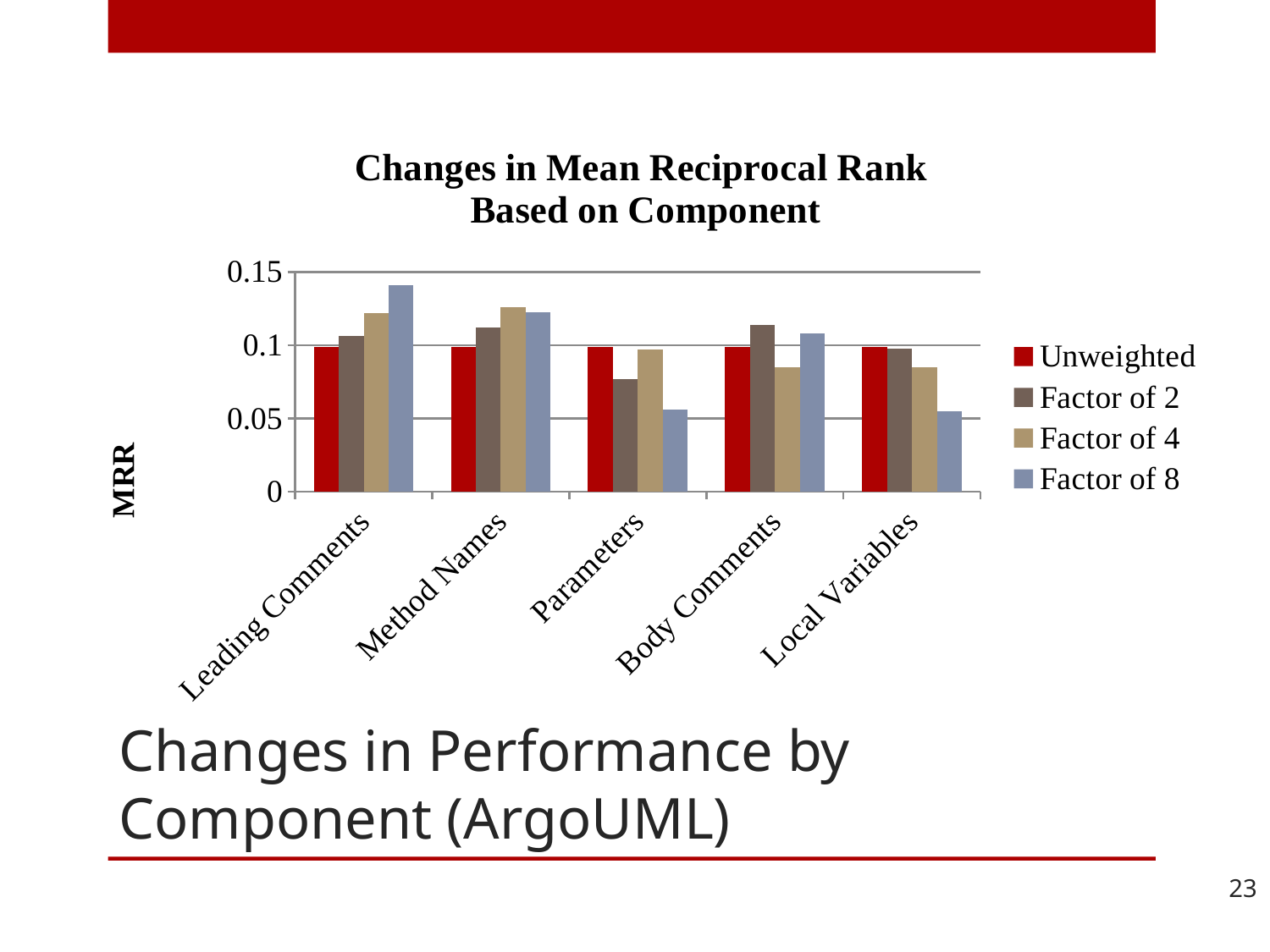
What kind of chart is shown on the slide? Bar chart What is the label on the vertical axis? MRR For Parameters, which is larger: the Factor of 2 value or the Factor of 8 value? Factor of 2 Is the Factor of 8 value for Leading Comments greater or less than 0.1? greater What is the title of the chart? Changes in Mean Reciprocal Rank Based on Component Is the Factor of 4 value for Body Comments greater or less than 0.1? less For which component is the Factor of 2 bar the lowest? Parameters For Leading Comments, which is larger: the Factor of 2 value or the Factor of 8 value? Factor of 8 How many component categories are shown on the x axis? 5 For which component is the Factor of 8 bar the highest? Leading Comments How many series does the legend list? 4 Is the Factor of 8 value for Parameters greater or less than 0.1? less